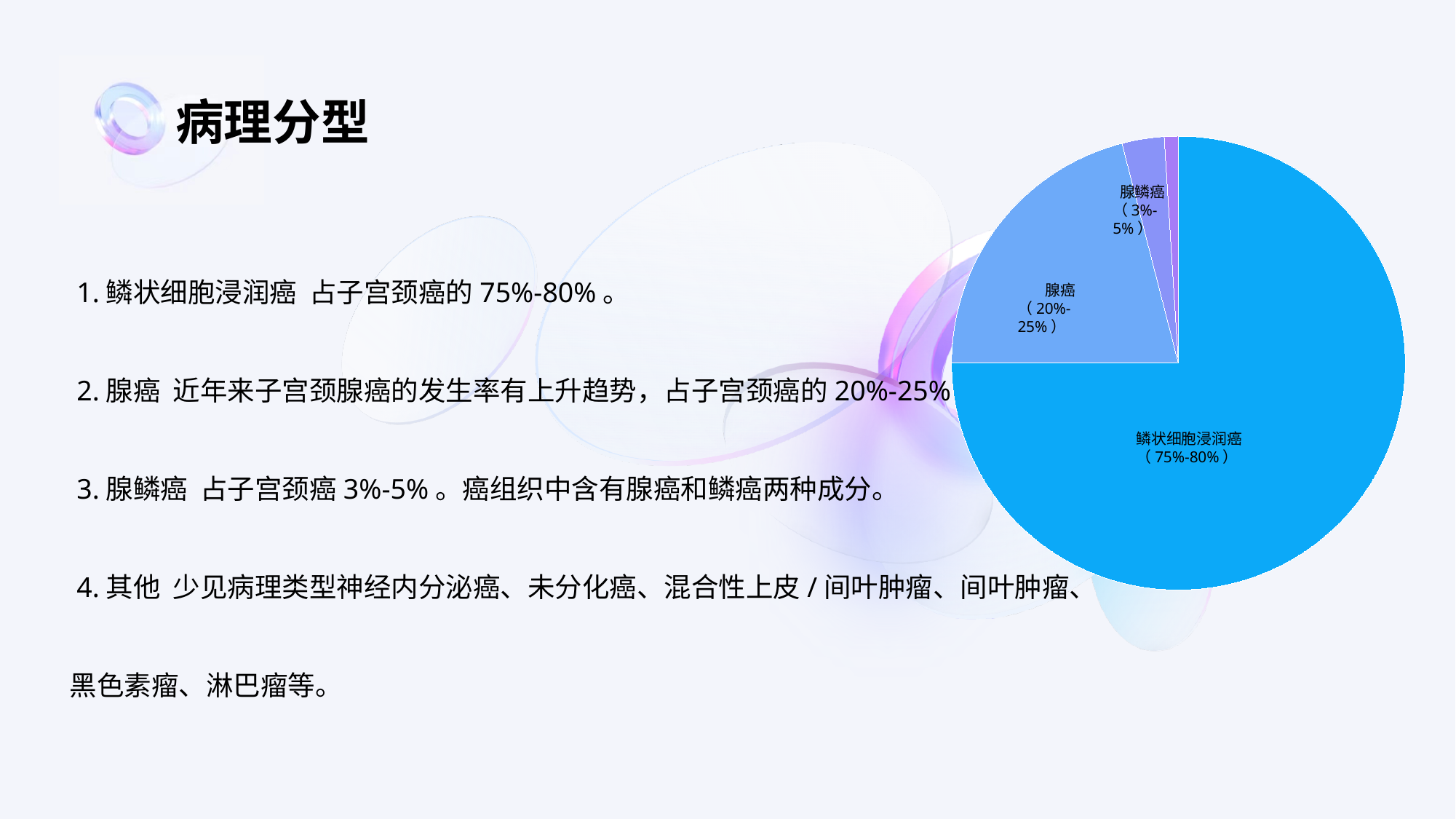
Which slice of the pie chart is labeled with the range 20%-25%? 腺癌 What colour is the largest slice of the pie chart? light blue What kind of chart is shown on the slide? pie chart Which labeled slice of the pie chart is the largest? 鳞状细胞浸润癌 What share does the pie chart label for 腺癌? 20%-25% Which labeled slice of the pie chart is the smallest? 腺鳞癌 What share does the pie chart label for 鳞状细胞浸润癌? 75%-80% Which slice is larger in the pie chart, 鳞状细胞浸润癌 or 腺癌? 鳞状细胞浸润癌 How many slices of the pie chart have a readable label? 3 What share does the pie chart label for 腺鳞癌? 3%-5% Which slice is larger in the pie chart, 腺癌 or 腺鳞癌? 腺癌 Does the 鳞状细胞浸润癌 slice take up more or less than half of the pie chart? more